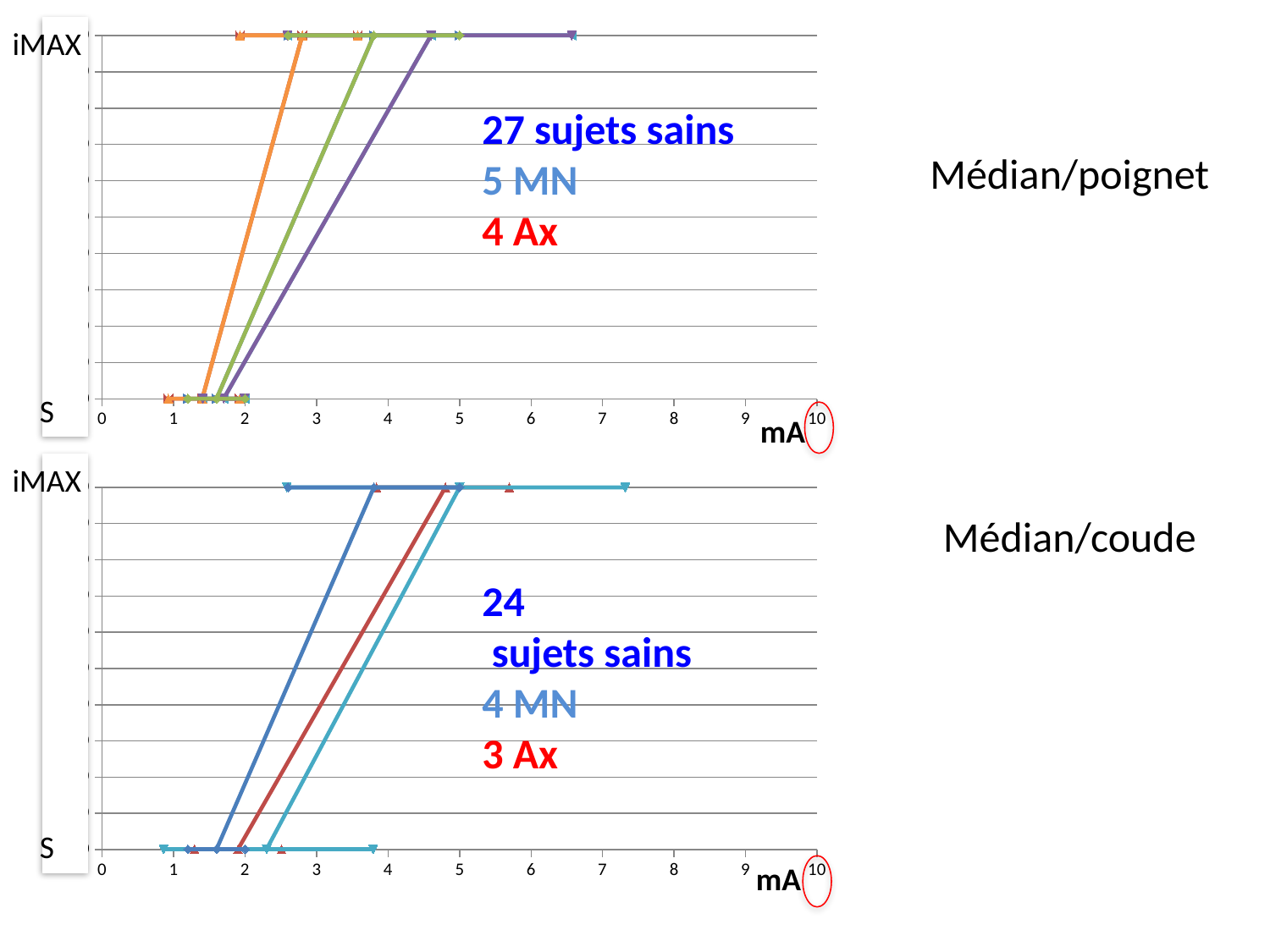
In the bottom chart (Médian/coude), is the x value at which the red line reaches iMAX greater or less than 4? greater In the bottom chart (Médian/coude), do the lines rise or fall from S to iMAX as the x value increases? rise In the bottom chart (Médian/coude), which line reaches iMAX at the lowest x value: dark blue, red or light blue? dark blue In the top chart (Médian/poignet), which line reaches iMAX at the lowest x value: orange, green or purple? orange How many charts are shown on the slide? 2 In the top chart (Médian/poignet), is the x value at which the green line reaches iMAX greater or less than 3? greater In the bottom chart (Médian/coude), is the x value at which the dark blue line reaches iMAX greater or less than 3? greater In the top chart (Médian/poignet), what unit is shown on the x axis? mA In the bottom chart (Médian/coude), what is the highest tick value on the x axis? 10 What kind of chart is the top chart labelled Médian/poignet? line chart